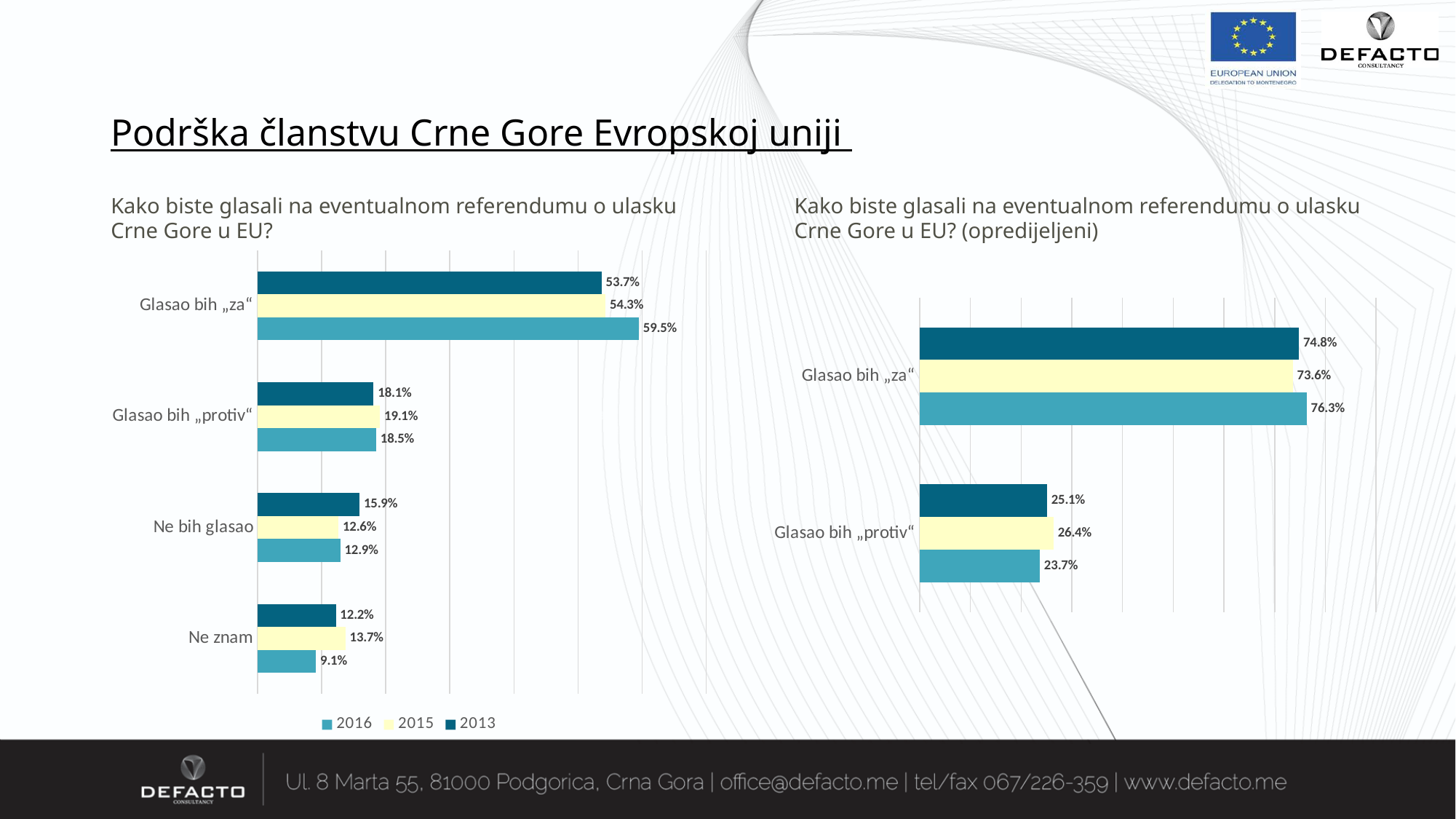
In the right chart (opredijeljeni), what is the 2016 value for "Glasao bih „za“"? 76.3% In the left chart ("Kako biste glasali na eventualnom referendumu o ulasku Crne Gore u EU?"), what is the 2016 value for "Glasao bih „za“"? 59.5% In the left chart, is the 2015 value for "Ne bih glasao" larger or smaller than the 2015 value for "Ne znam"? smaller In the right chart (opredijeljeni), what is the difference between the 2013 and 2016 values for "Glasao bih „protiv“"? 1.4% How many series does the legend on the slide list? 3 In the right chart (opredijeljeni), what is the 2015 value for "Glasao bih „protiv“"? 26.4% In the left chart, what is the 2015 value for "Ne znam"? 13.7% In the left chart, what is the difference between the 2016 and 2013 values for "Glasao bih „za“"? 5.8% In the left chart, what is the 2013 value for "Ne bih glasao"? 15.9% In the left chart, which category has the highest 2013 value? Glasao bih „za“ How many categories does the left chart show? 4 In the left chart, which category has the lowest 2016 value? Ne znam